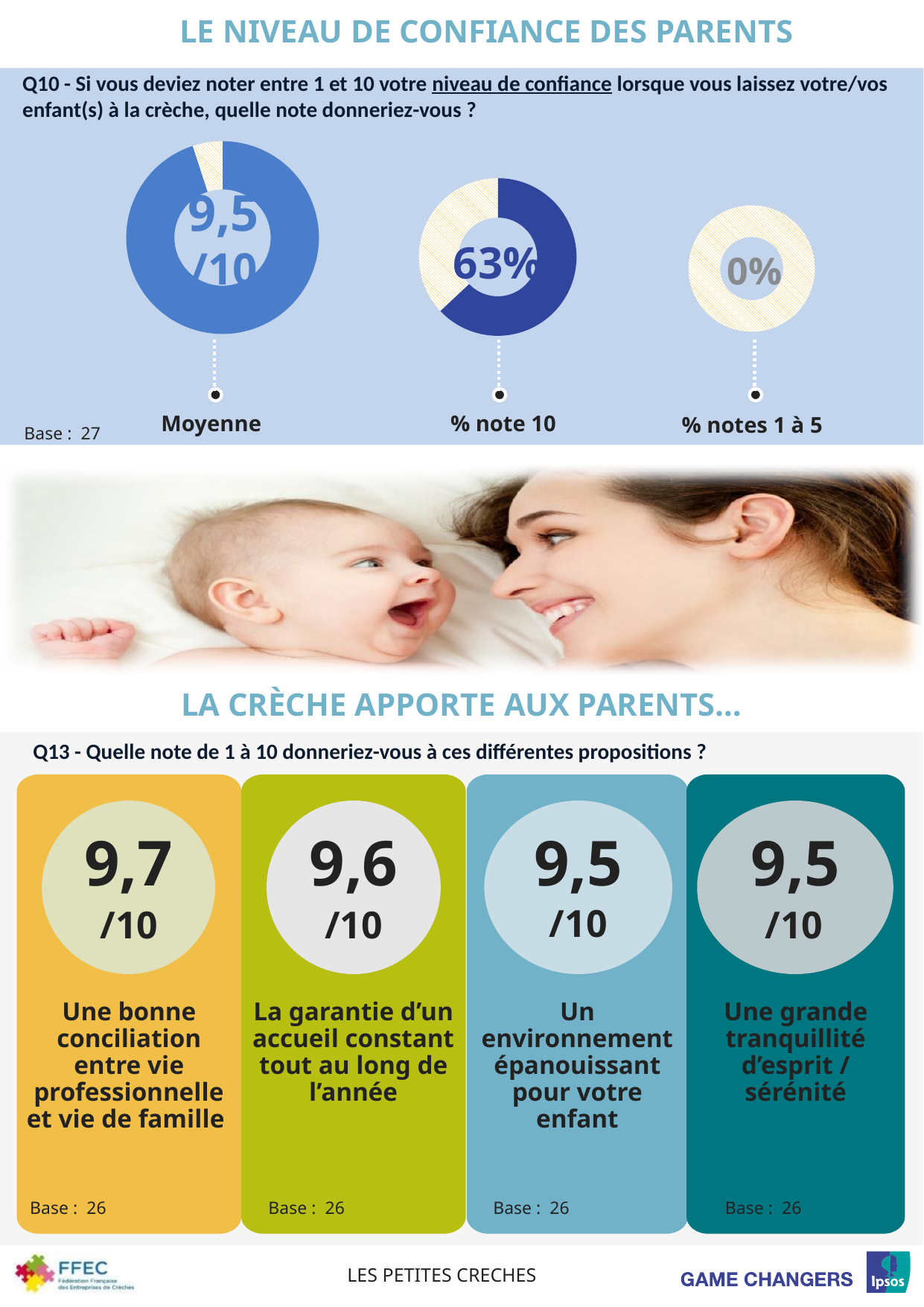
In the top section, which is larger: the '% note 10' value or the '% notes 1 à 5' value? % note 10 In the bottom section, which proposition has the highest score? Une bonne conciliation entre vie professionnelle et vie de famille What kind of chart is used to display the '% note 10' value? Donut chart How many donut charts are shown in the top section of the slide? 3 In the top section, what is the value shown in the 'Moyenne' donut chart? 9,5/10 In the top section, is the '% note 10' value greater or less than 50%? greater What is the base (number of respondents) indicated for the top section donut charts? 27 In the bottom section, what score is given to 'Une bonne conciliation entre vie professionnelle et vie de famille'? 9,7/10 In the top section, what percentage is shown in the '% notes 1 à 5' donut chart? 0% In the top section, what percentage is shown in the '% note 10' donut chart? 63% In the bottom section, what score is given to 'La garantie d'un accueil constant tout au long de l'année'? 9,6/10 In the bottom section, what is the difference between the score for 'Une bonne conciliation entre vie professionnelle et vie de famille' and the score for 'Une grande tranquillité d'esprit / sérénité'? 0,2